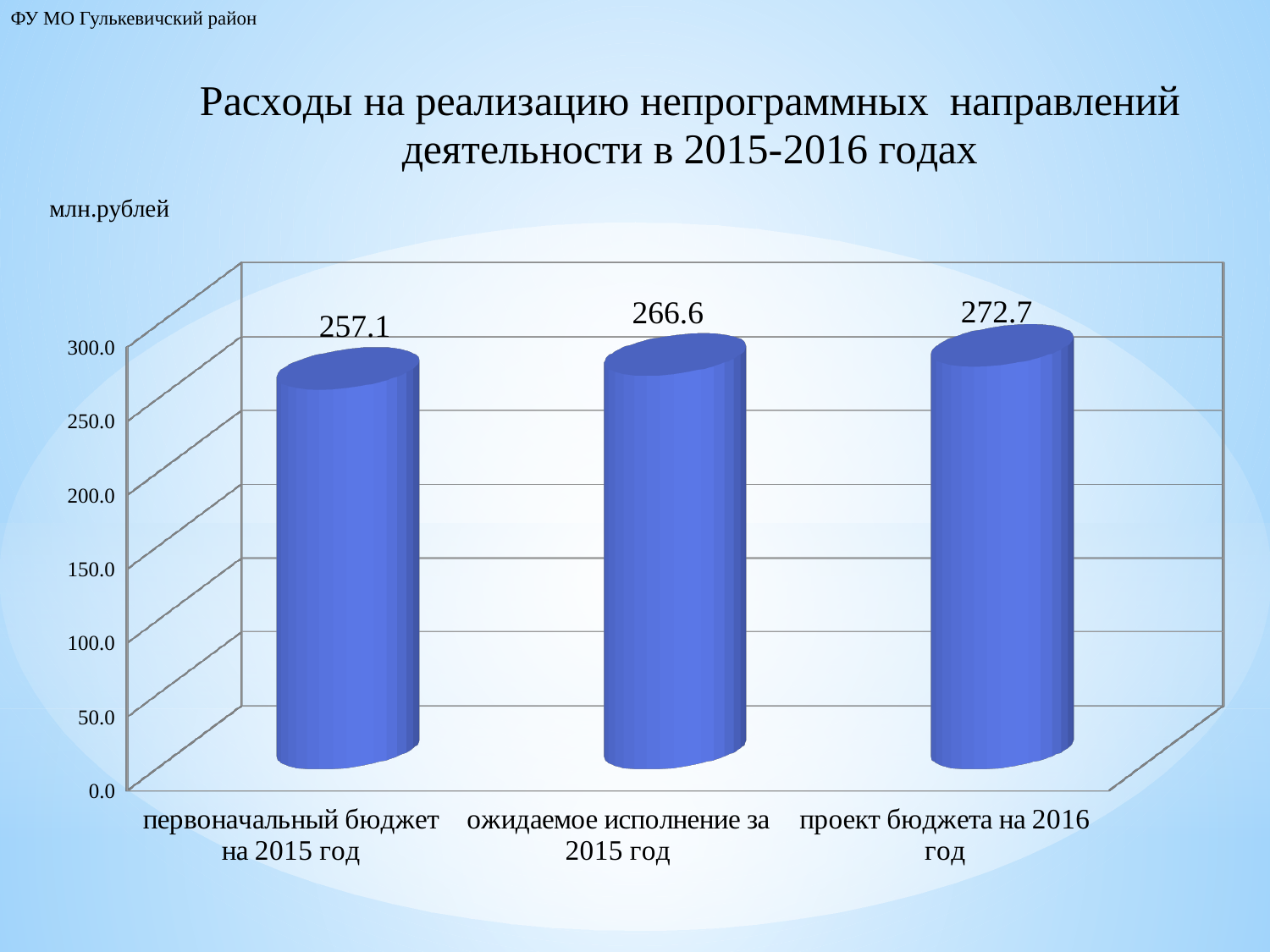
What is the value for «первоначальный бюджет на 2015 год»? 257.1 What is the value for «ожидаемое исполнение за 2015 год»? 266.6 Is the value for «первоначальный бюджет на 2015 год» greater or less than 250.0? greater Do the values rise or fall from left to right across the categories? rise What is the difference between «проект бюджета на 2016 год» and «первоначальный бюджет на 2015 год»? 15.6 How many categories are shown in the chart? 3 What is the value for «проект бюджета на 2016 год»? 272.7 Which category has the highest value? проект бюджета на 2016 год Which is larger: «ожидаемое исполнение за 2015 год» or «проект бюджета на 2016 год»? проект бюджета на 2016 год What is the difference between «ожидаемое исполнение за 2015 год» and «первоначальный бюджет на 2015 год»? 9.5 Which category has the lowest value? первоначальный бюджет на 2015 год What kind of chart is shown on the slide? bar chart